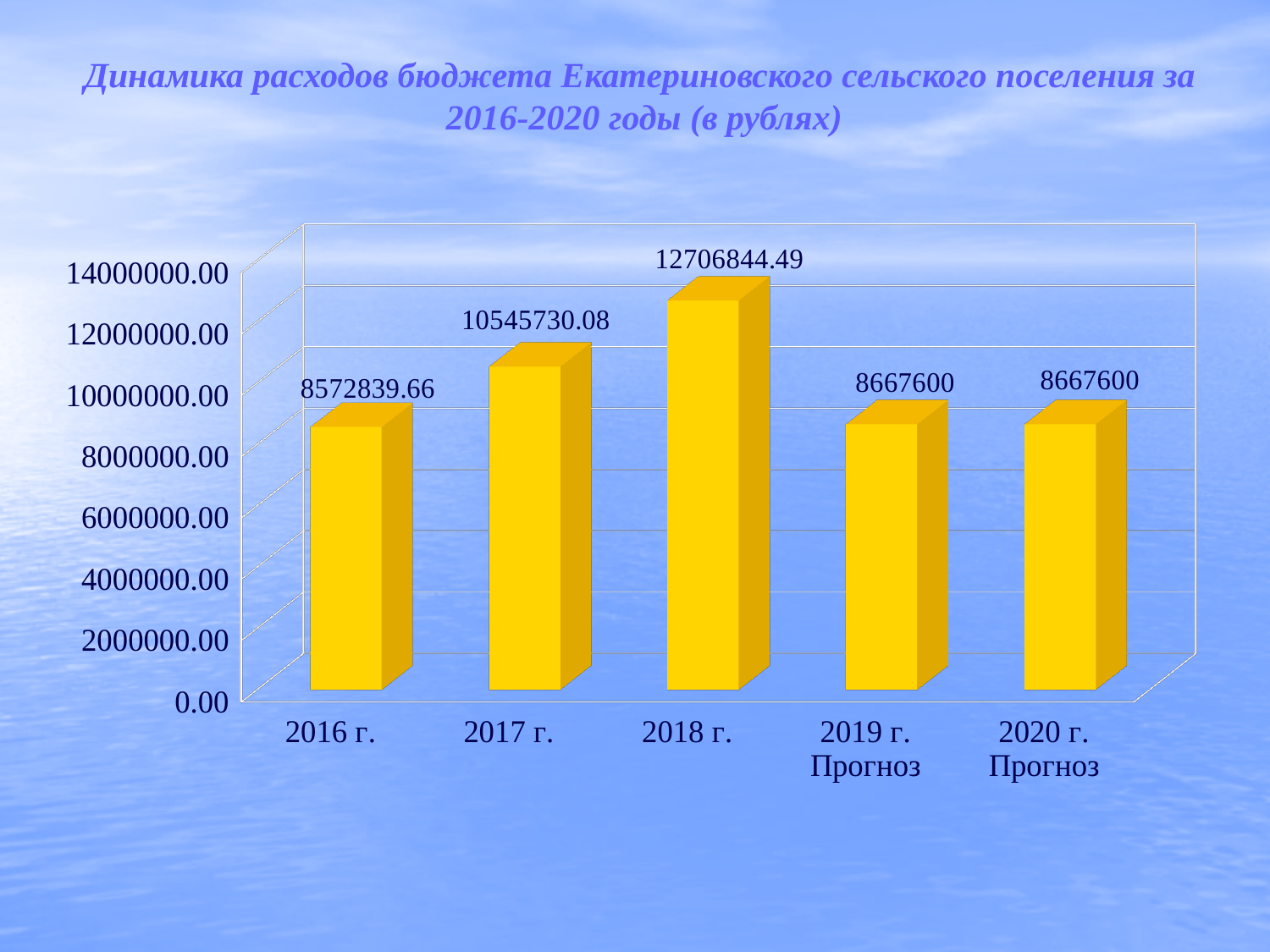
What is the value for 2018 г.? 12706844.49 Is the value for 2017 г. greater or less than 10000000.00? greater What kind of chart is shown on the slide? bar chart What is the value for 2016 г.? 8572839.66 What is the difference between the values for 2017 г. and 2016 г.? 1972890.42 Which year has the highest value? 2018 г. What is the value for 2019 г. Прогноз? 8667600 How many categories are shown on the x axis? 5 Which is larger, the value for 2017 г. or the value for 2020 г. Прогноз? 2017 г. Do the values rise or fall from 2016 г. to 2018 г.? rise What is the difference between the values for 2018 г. and 2017 г.? 2161114.41 Which year has the lowest value? 2016 г.